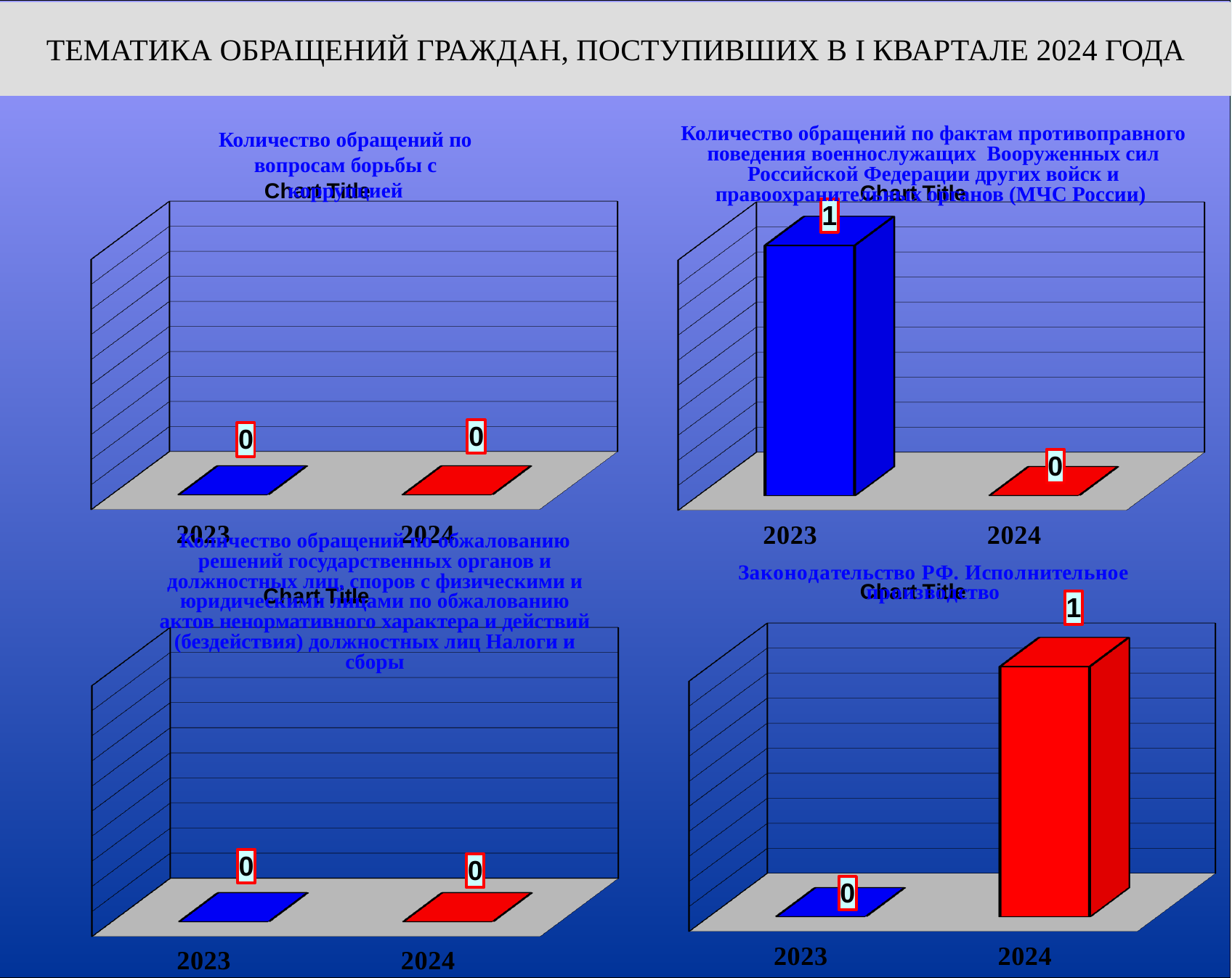
In the bottom-left chart, what is the value for 2023? 0 In the bottom-right chart, which year has the lower value? 2023 How many categories are shown on the x axis of the bottom-left chart? 2 In the bottom-right chart, what is the difference between the values for 2024 and 2023? 1 In the top-left chart, what is the value for 2024? 0 In the bottom-right chart, what is the value for 2023? 0 In the top-right chart, what is the value for 2023? 1 In the bottom-right chart, what is the value for 2024? 1 In the top-right chart, is the value for 2023 larger or smaller than the value for 2024? larger In the top-right chart, which year has the higher value? 2023 In the top-right chart, what is the value for 2024? 0 What kind of chart is the top-right chart? bar chart